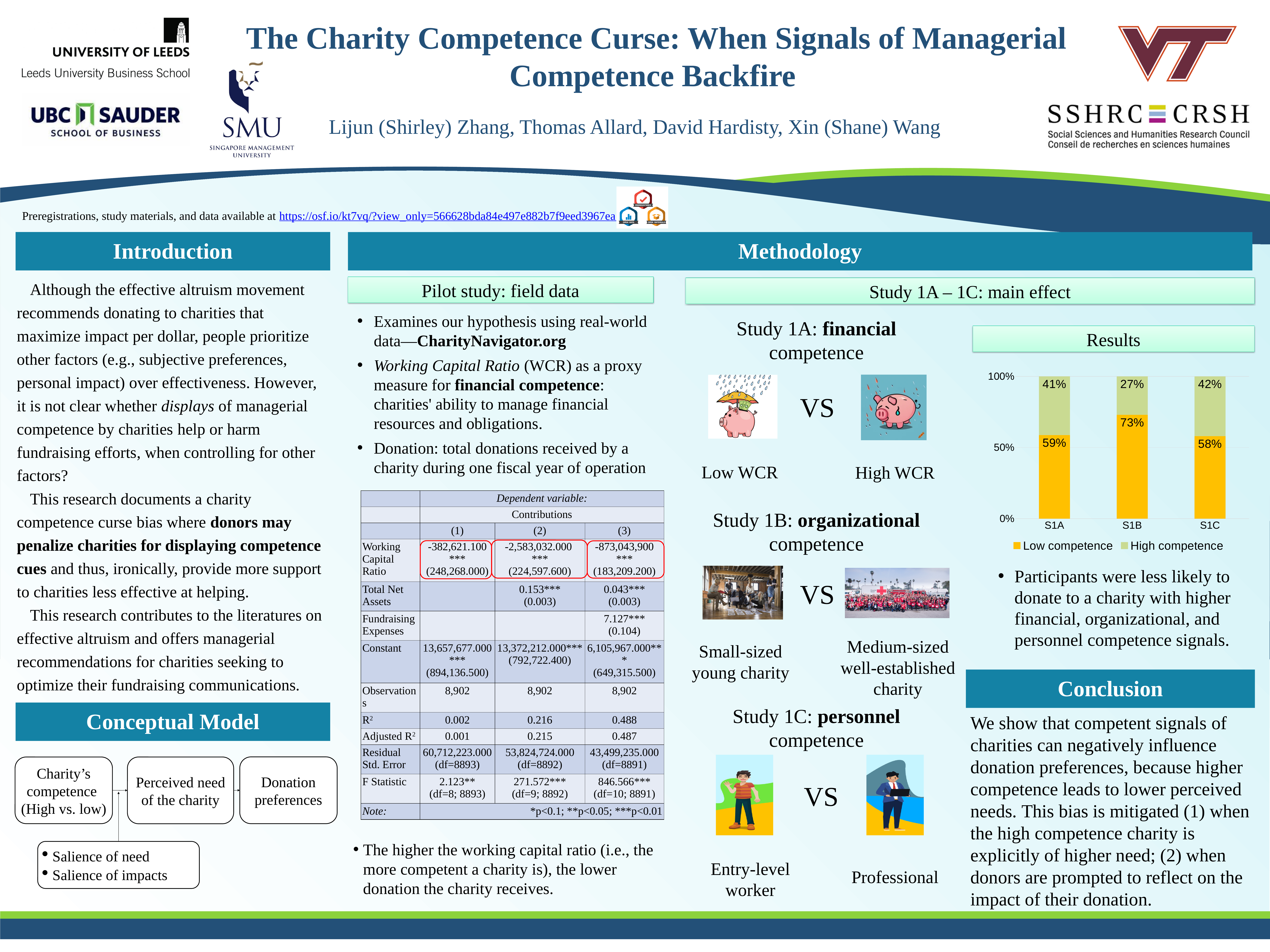
In the Results chart, which colour represents Low competence? Yellow How many series does the legend of the Results chart list? 2 In the Results chart, what is the value for Low competence in S1B? 73% How many studies (categories) are shown on the x axis of the Results chart? 3 What kind of chart is the Results chart? Stacked bar chart In the Results chart, what is the value for Low competence in S1A? 59% In the Results chart, which study has the highest Low competence value? S1B In the Results chart, what is the value for High competence in S1A? 41% In the Results chart, what is the value for High competence in S1C? 42% In the Results chart, which study has the lowest High competence value? S1B In the Results chart, what is the difference between the Low competence and High competence values for S1B? 46% In the Results chart, which is larger for S1C: Low competence or High competence? Low competence